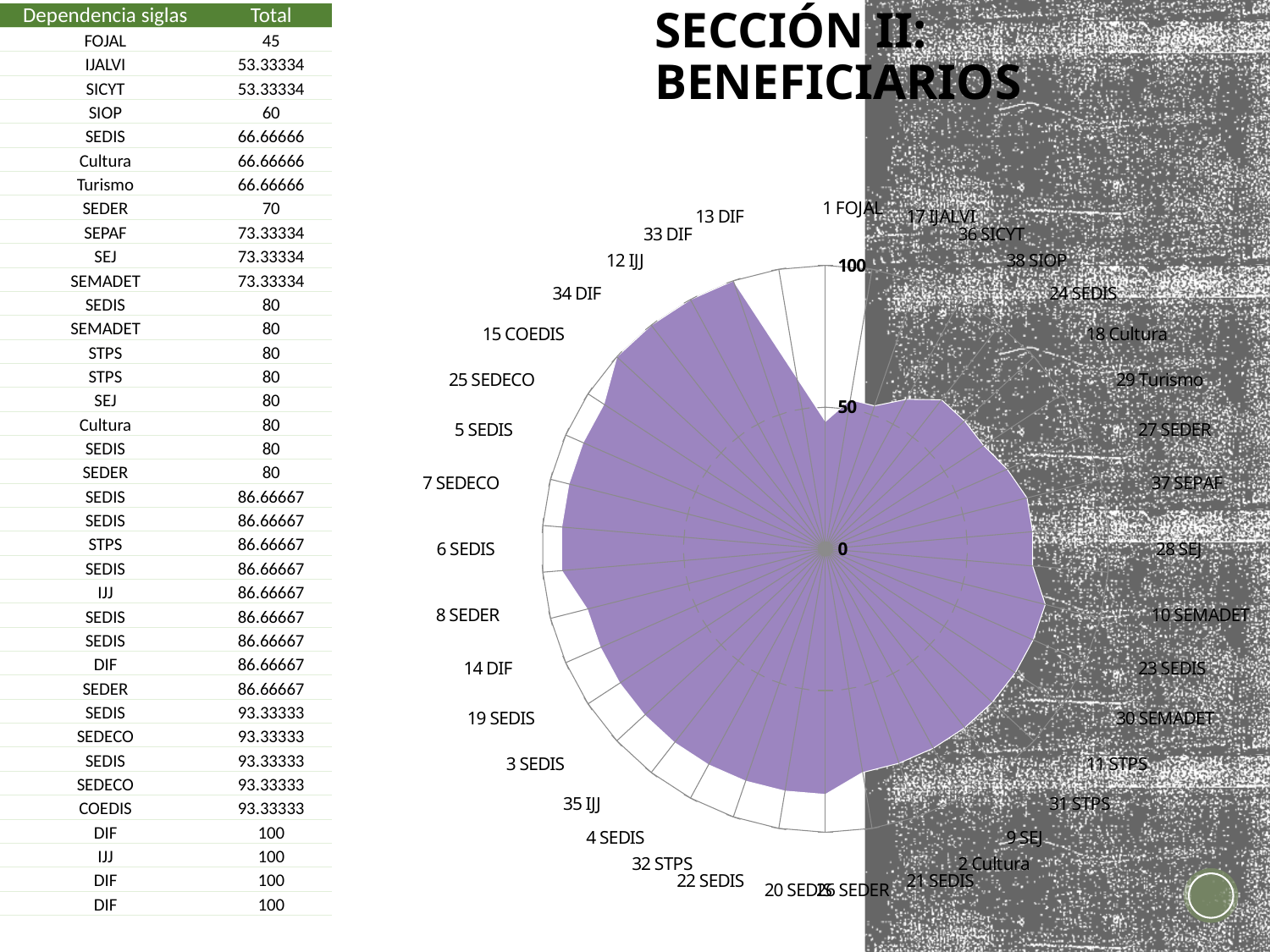
What colour is the filled area of the radar chart? purple According to the table, what is the Total for FOJAL? 45 What is the maximum value shown on the radar chart's axis? 100 Is the value for 13 DIF on the radar chart greater or less than 50? greater What kind of chart is shown on the slide? radar chart Going clockwise around the radar chart from 1 FOJAL to 13 DIF, do the values rise or fall? rise According to the table, what is the Total for SIOP? 60 Is the value for 1 FOJAL on the radar chart greater or less than 50? less According to the table, what is the Total for SEPAF? 73.33334 Is the value for 6 SEDIS on the radar chart greater or less than 50? greater Which category on the radar chart has the lowest value? 1 FOJAL